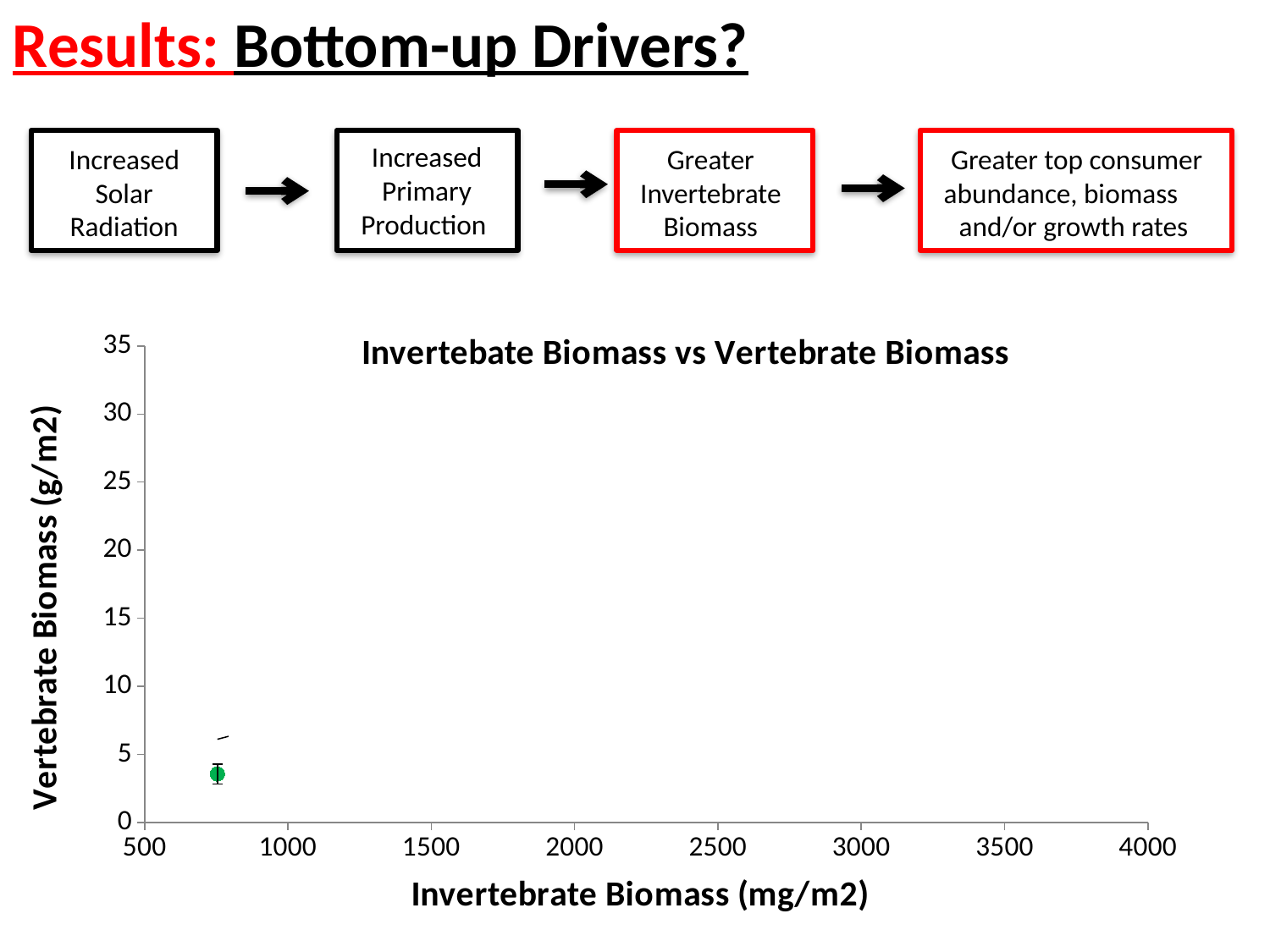
What is the label of the y axis of the chart? Vertebrate Biomass (g/m2) Is the vertebrate biomass value of the plotted point greater or less than 10? less What kind of chart is shown on the slide? scatter plot Is the invertebrate biomass value of the plotted point greater or less than 500? greater What is the title of the chart? Invertebate Biomass vs Vertebrate Biomass Is the vertebrate biomass value of the plotted point greater or less than 5? less How many data points are plotted on the chart? 1